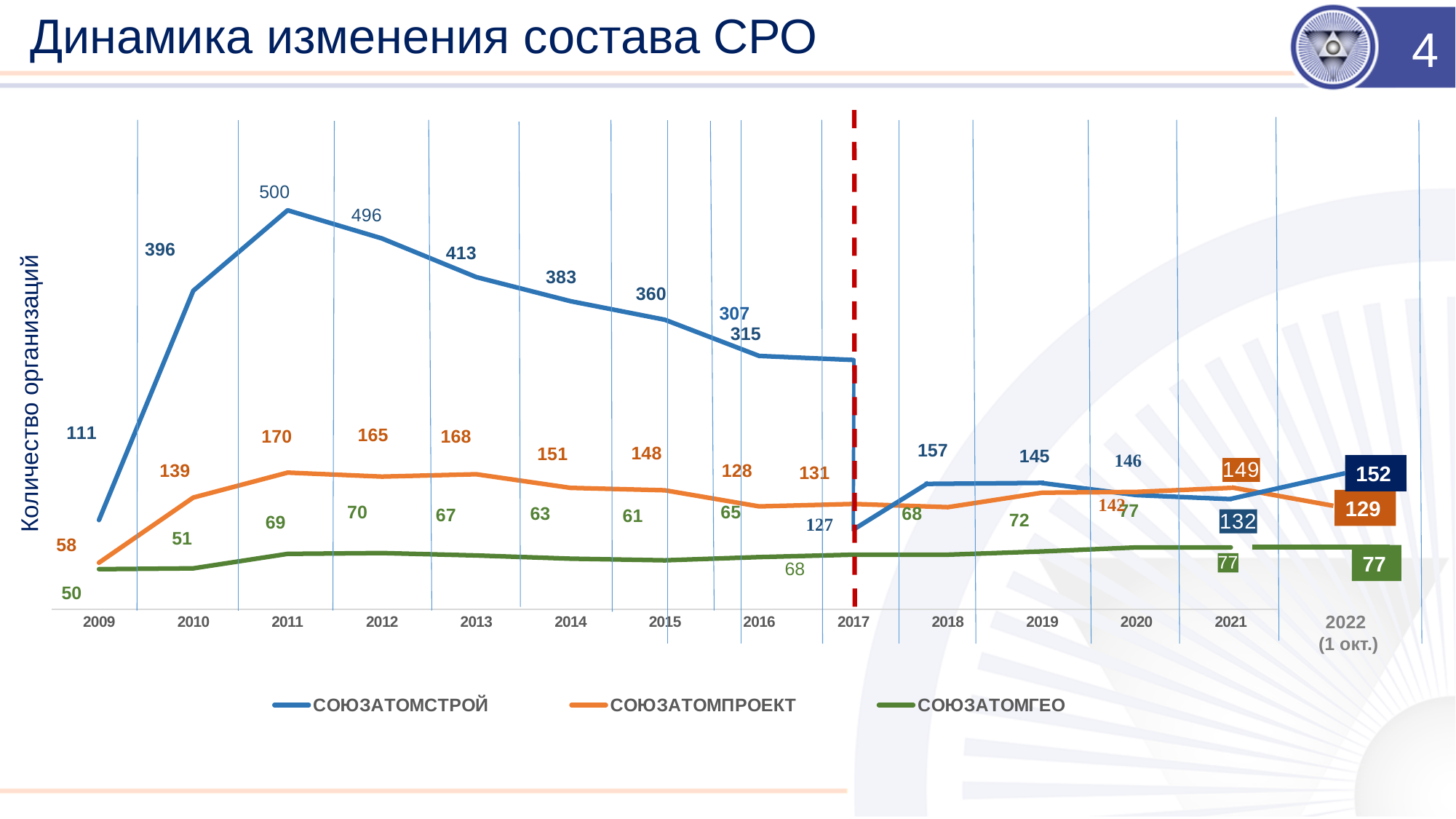
What is the value for СОЮЗАТОМПРОЕКТ in 2011? 170 What is the title of the vertical axis? Количество организаций In which year does СОЮЗАТОМСТРОЙ reach its highest value? 2011 What is the value for СОЮЗАТОМГЕО in 2009? 50 What is the value for СОЮЗАТОМСТРОЙ in 2011? 500 How many series does the legend list? 3 What is the value for СОЮЗАТОМПРОЕКТ in 2022 (1 окт.)? 129 Does the СОЮЗАТОМСТРОЙ line rise or fall from 2011 to 2016? fall What is the value for СОЮЗАТОМСТРОЙ in 2022 (1 окт.)? 152 What is the difference between the СОЮЗАТОМСТРОЙ values in 2011 and 2012? 4 What kind of chart is shown on the slide? line chart Which series has the larger value in 2022 (1 окт.): СОЮЗАТОМСТРОЙ or СОЮЗАТОМПРОЕКТ? СОЮЗАТОМСТРОЙ